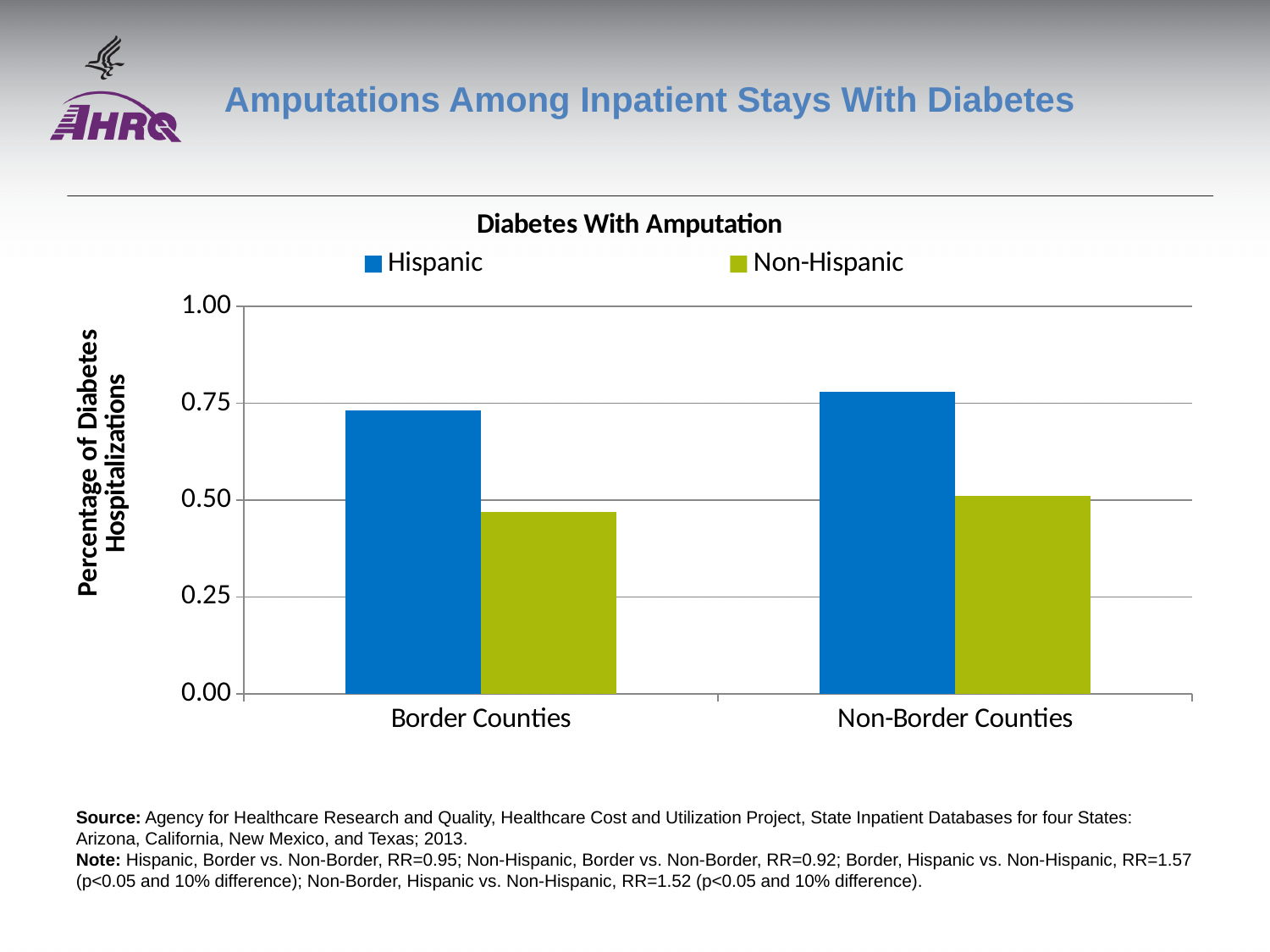
Which group has the highest bar in the chart? Hispanic, Non-Border Counties Which group has the lowest bar in the chart? Non-Hispanic, Border Counties How many series does the legend list in the Diabetes With Amputation chart? 2 How many county categories are shown on the x axis of the chart? 2 What is the label of the y axis? Percentage of Diabetes Hospitalizations Is the Hispanic value for Border Counties greater or less than 0.50? greater In Border Counties, which is larger: the Hispanic or the Non-Hispanic value? Hispanic Is the Non-Hispanic value for Border Counties greater or less than 0.50? less What is the title of the chart? Diabetes With Amputation Is the Non-Hispanic value for Non-Border Counties greater or less than 0.75? less What kind of chart is shown on the slide? bar chart In Non-Border Counties, which is larger: the Hispanic or the Non-Hispanic value? Hispanic